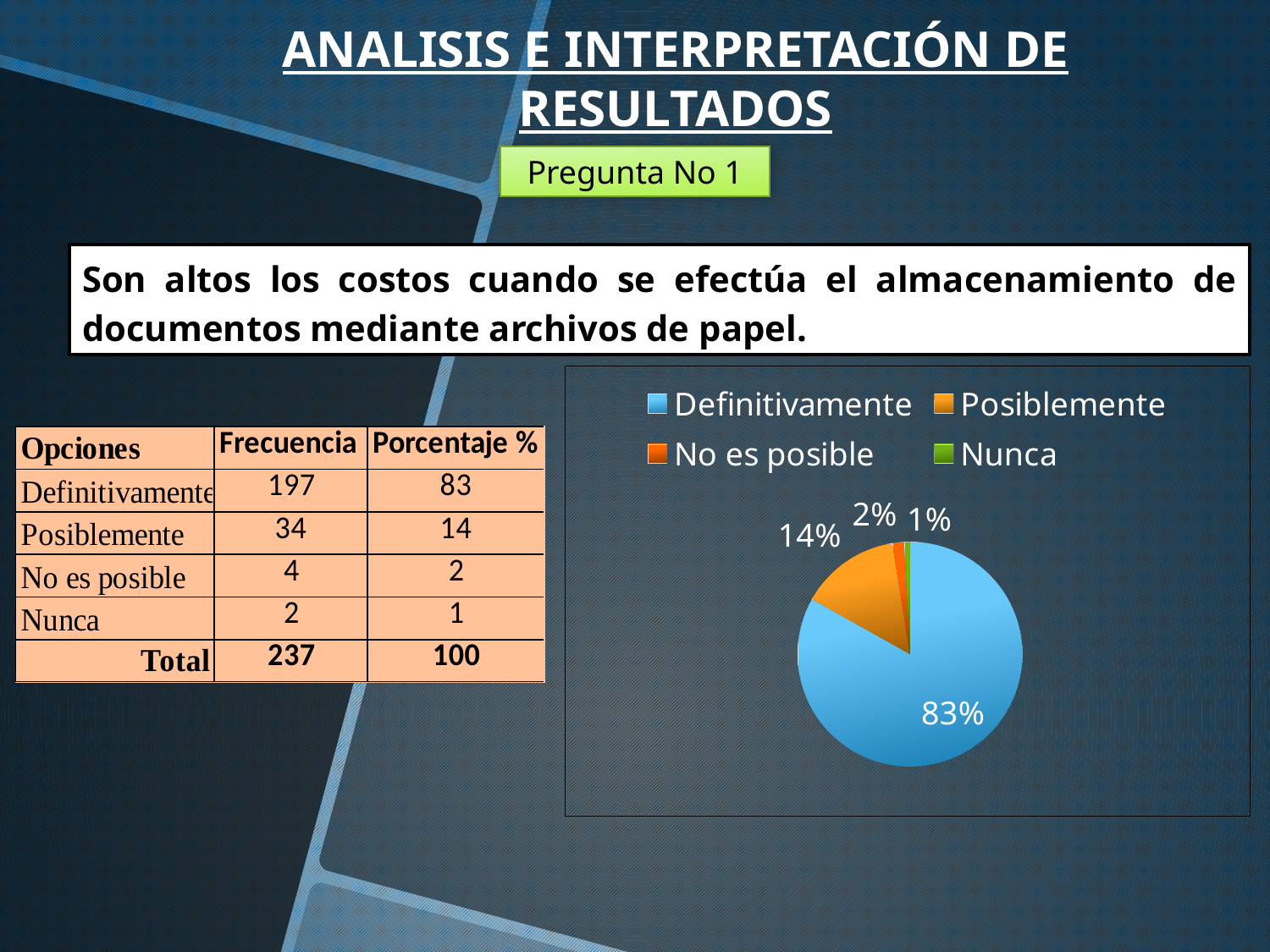
How many slices does the pie chart have? 4 What percentage does the pie chart show for Posiblemente? 14% Which category has the smallest slice in the pie chart? Nunca How many entries does the pie chart legend list? 4 What percentage does the pie chart show for Definitivamente? 83% Which slice is larger in the pie chart, Posiblemente or No es posible? Posiblemente What colour is the Definitivamente slice in the pie chart? blue What percentage does the pie chart show for Nunca? 1% What kind of chart is shown on the slide? pie chart What is the difference in percentage points between Definitivamente and Posiblemente in the pie chart? 69 Which category has the largest slice in the pie chart? Definitivamente What percentage does the pie chart show for No es posible? 2%